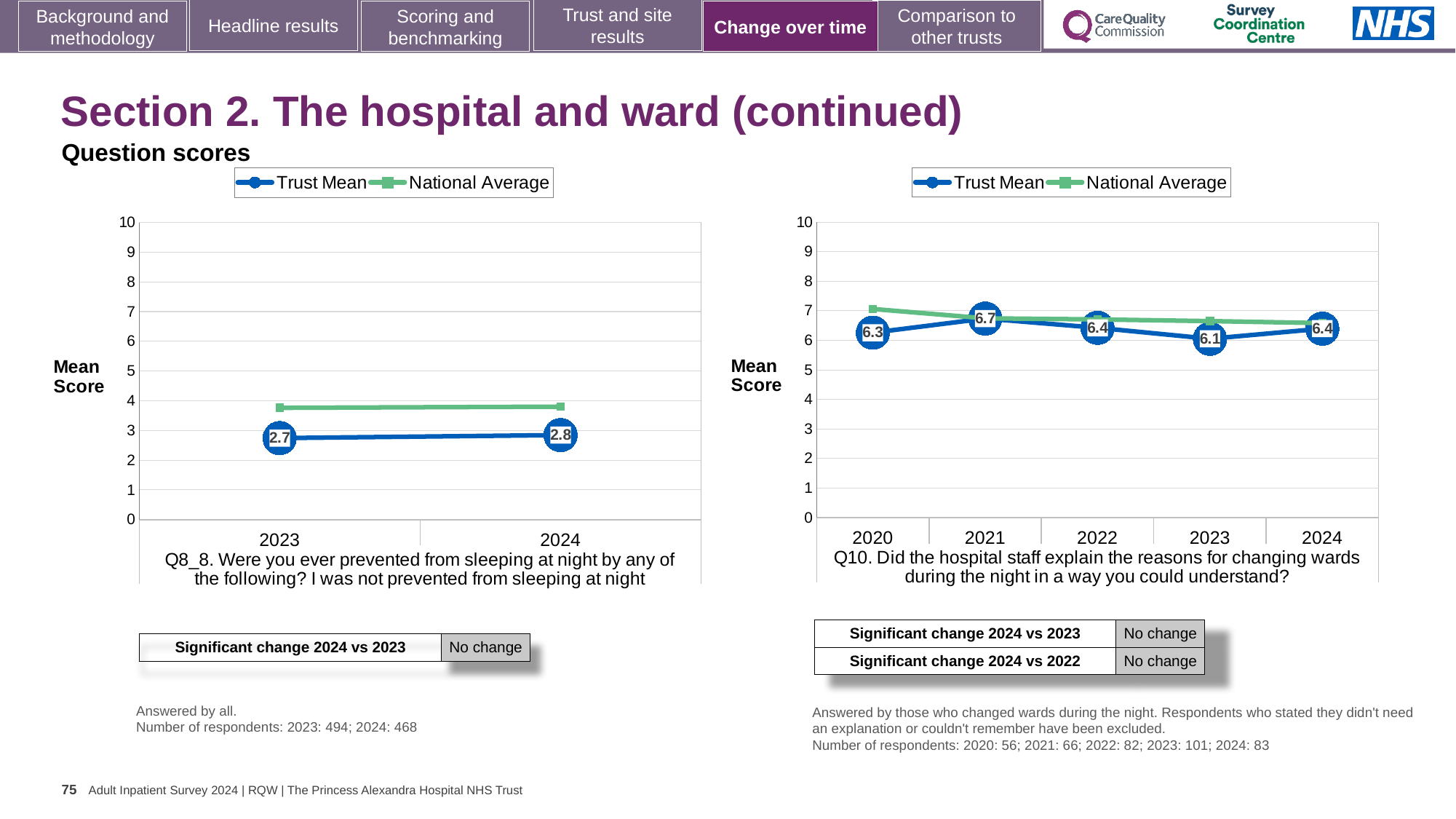
In the Q8_8 chart on the left, what is the Trust Mean score for 2024? 2.8 In the Q8_8 chart on the left, is the National Average value for 2023 greater or less than 3? greater In the Q10 chart on the right, what is the Trust Mean score for 2021? 6.7 In the Q10 chart on the right, what is the difference between the Trust Mean scores for 2021 and 2023? 0.6 In the Q10 chart on the right, what is the Trust Mean score for 2023? 6.1 In the Q8_8 chart on the left, what is the Trust Mean score for 2023? 2.7 How many series does the legend of the Q8_8 chart on the left list? 2 In the Q10 chart on the right, which year has the highest Trust Mean score? 2021 In the Q8_8 chart on the left, is the Trust Mean for 2024 higher or lower than for 2023? higher How many years are plotted on the x axis of the Q10 chart on the right? 5 What type of chart is the Q10 chart on the right? line chart In the Q10 chart on the right, which year has the lowest Trust Mean score? 2023